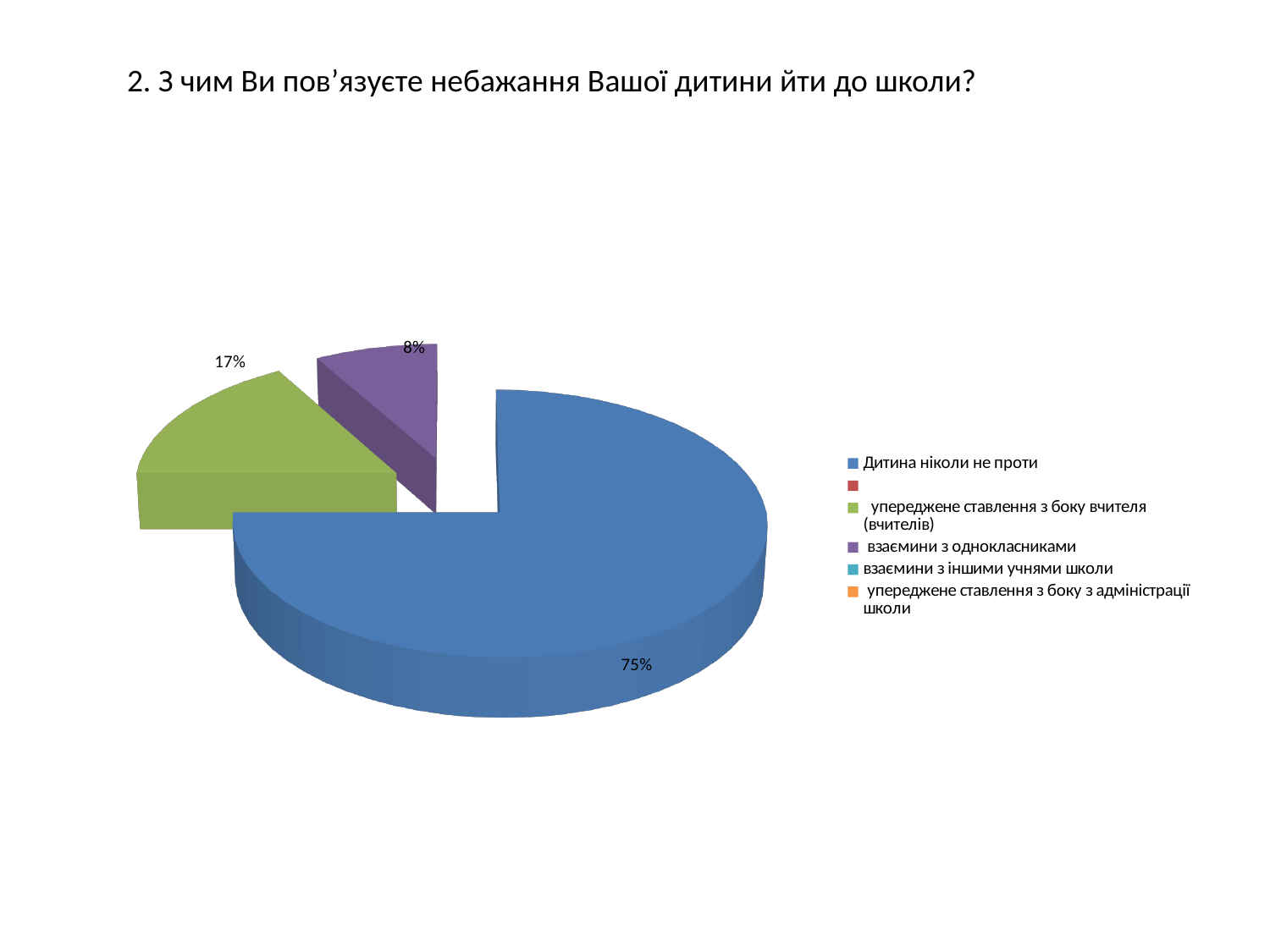
What is the difference between the share for "Дитина ніколи не проти" and the share for "упереджене ставлення з боку вчителя (вчителів)"? 58% What colour is the slice for "Дитина ніколи не проти"? blue Which labelled slice of the pie is the smallest? взаємини з однокласниками What share of the pie does "упереджене ставлення з боку вчителя (вчителів)" have? 17% What share of the pie does "Дитина ніколи не проти" have? 75% How many slices with data labels are visible in the pie chart? 3 Which category has the largest slice of the pie? Дитина ніколи не проти What is the title of the slide above the chart? 2. З чим Ви пов’язуєте небажання Вашої дитини йти до школи? Which is larger: the slice for "упереджене ставлення з боку вчителя (вчителів)" or the slice for "взаємини з однокласниками"? упереджене ставлення з боку вчителя (вчителів) What kind of chart is shown on the slide? pie chart What share of the pie does "взаємини з однокласниками" have? 8% What is the difference between the share for "упереджене ставлення з боку вчителя (вчителів)" and the share for "взаємини з однокласниками"? 9%